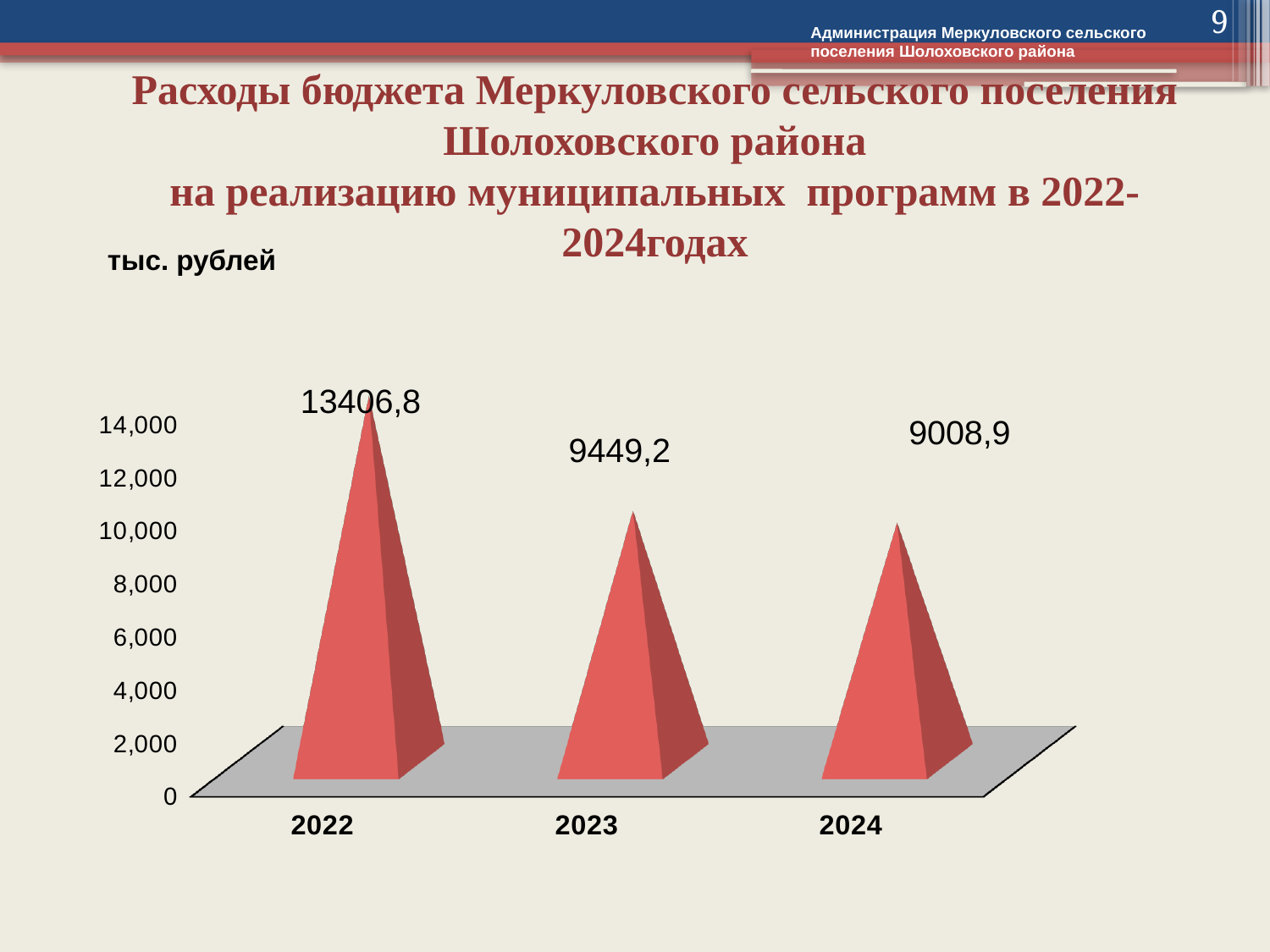
What is the value for 2023? 9449,2 Is the value for 2023 greater or less than 10,000? less Do the values rise or fall from 2022 to 2024? fall What is the difference between the values for 2022 and 2023? 3957,6 How many years are shown on the x axis? 3 What is the difference between the values for 2023 and 2024? 440,3 What is the value for 2024? 9008,9 Which is larger, the value for 2023 or the value for 2024? 2023 Which year has the lowest value? 2024 What kind of chart is shown on the slide? bar chart What is the value for 2022? 13406,8 Which year has the highest value? 2022